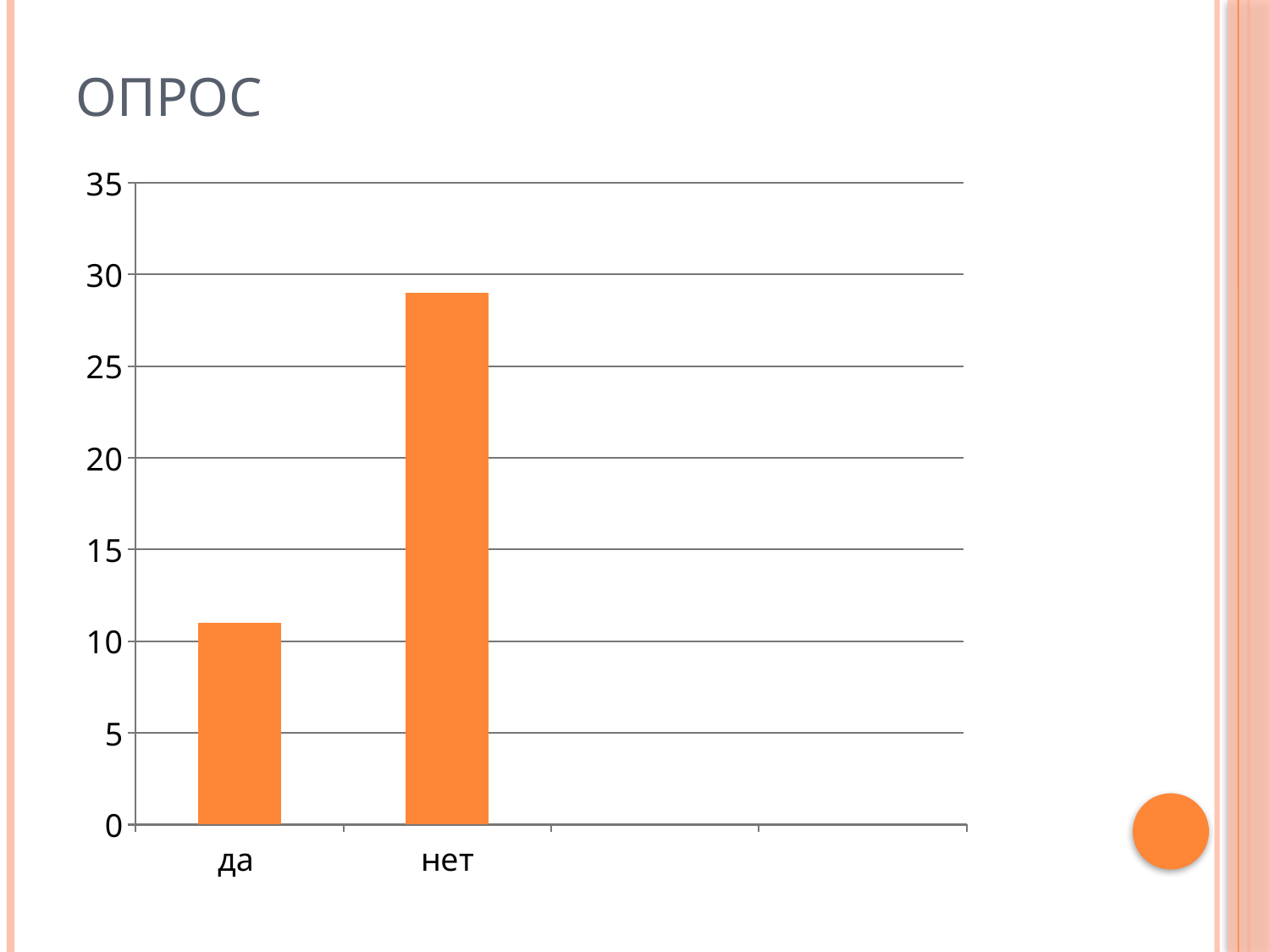
Which is larger, the value for да or the value for нет? нет How many categories are shown on the x axis of the chart? 2 Is the value for да greater or less than 15? less Do the bar values rise or fall from да to нет along the x axis? rise What colour are the bars in the chart? orange Which category has the lowest bar? да Is the value for да greater or less than 5? greater What is the title of the slide with the chart? ОПРОС What kind of chart is shown on the slide? bar chart Is the value for нет greater or less than 25? greater Which category has the highest bar? нет